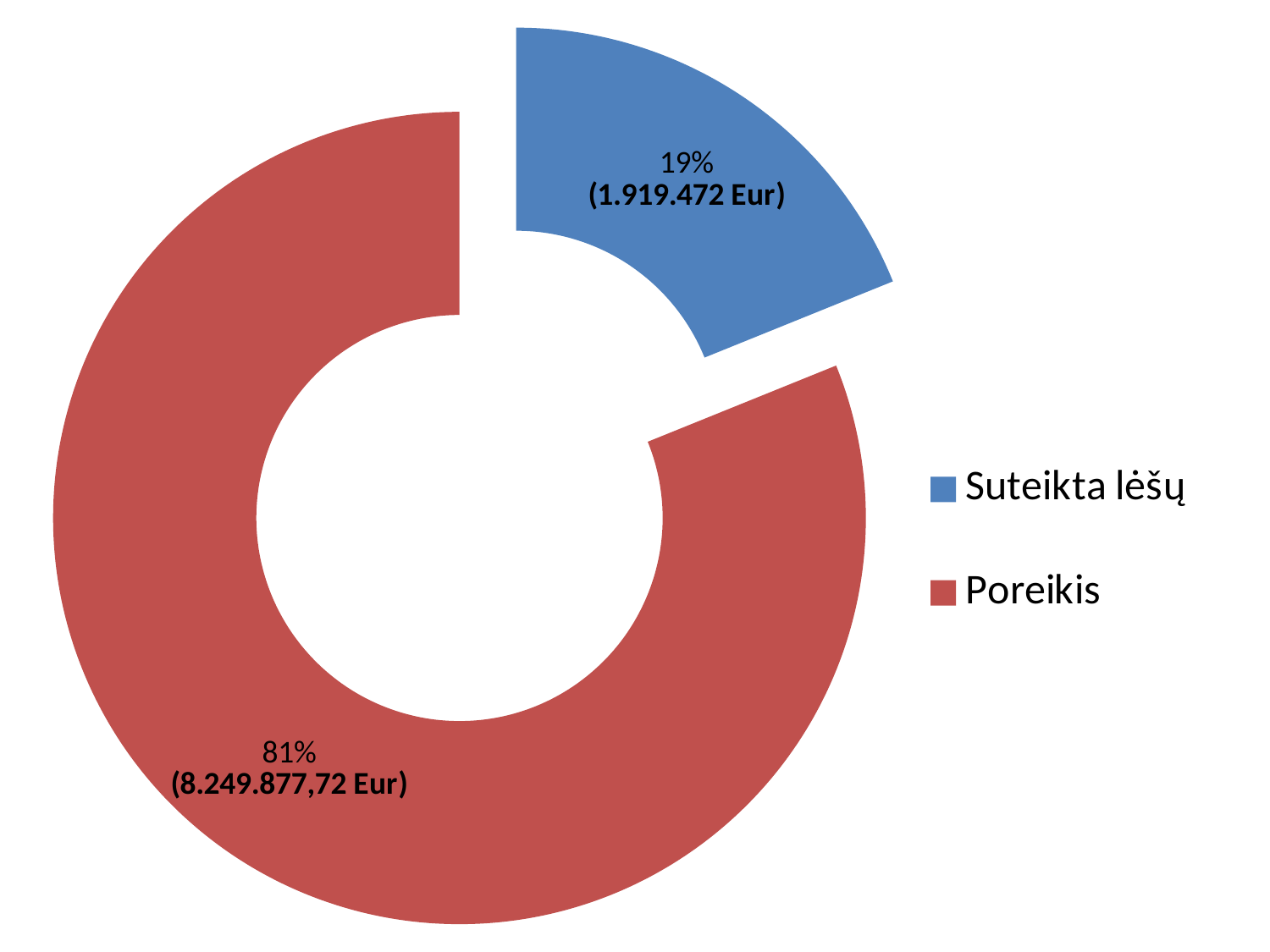
What amount in Eur is shown for Suteikta lėšų? 1.919.472 Eur How many categories are shown in the chart? 2 Which category has the smallest share of the chart? Suteikta lėšų What kind of chart is shown on the slide? Doughnut (pie) chart What is the difference in percentage points between the Poreikis share and the Suteikta lėšų share? 62 What share of the doughnut chart does Poreikis represent? 81% What amount in Eur is shown for Poreikis? 8.249.877,72 Eur Which is larger, the share for Suteikta lėšų or the share for Poreikis? Poreikis Which category has the largest share of the chart? Poreikis What colour is the Poreikis segment? Red How many entries does the legend list? 2 What share of the doughnut chart does Suteikta lėšų represent? 19%